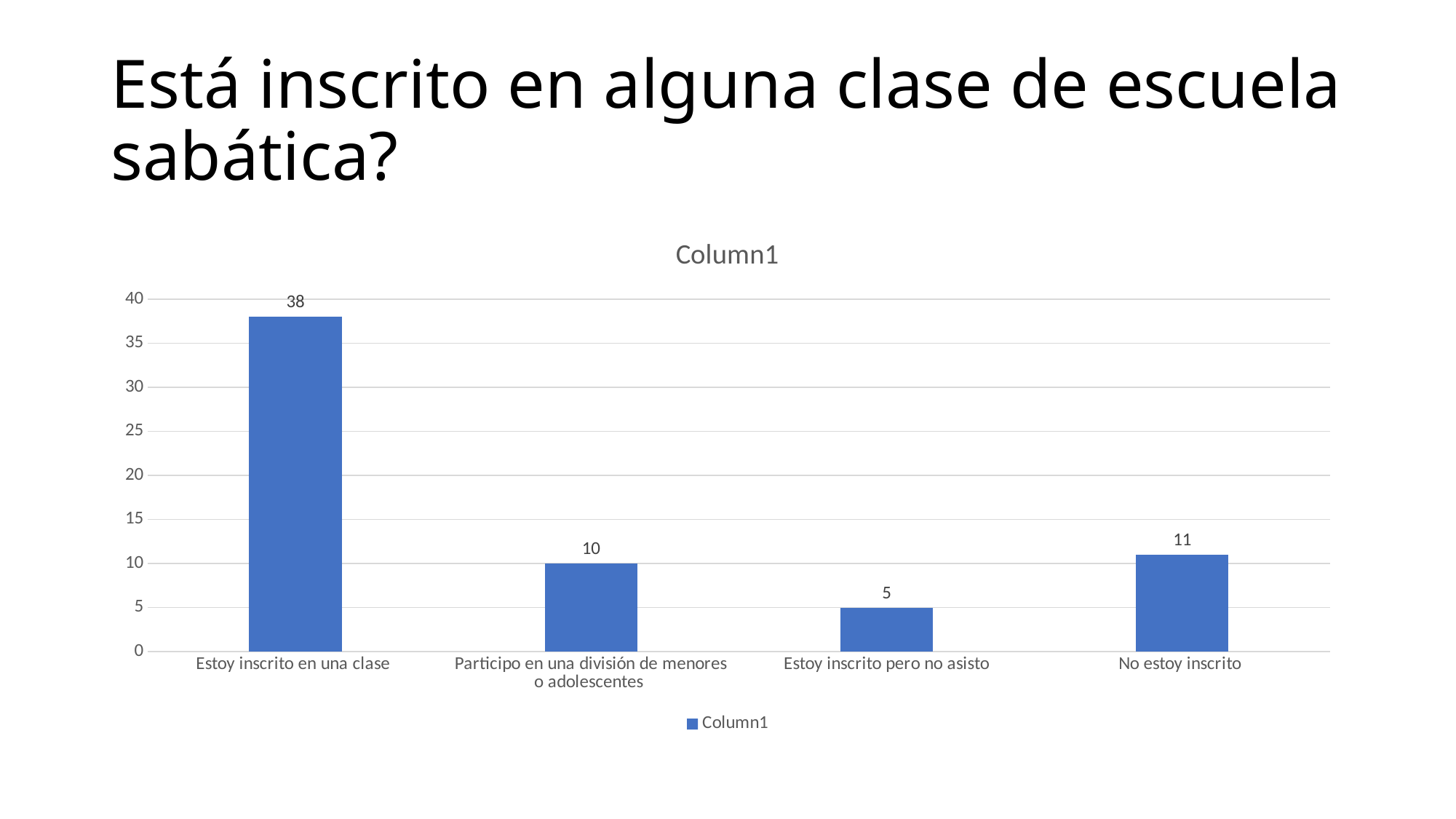
How many categories are shown on the x axis? 4 What is the value for "Estoy inscrito pero no asisto"? 5 Is the value for "Estoy inscrito en una clase" greater or less than 35? greater Which category has the highest value? Estoy inscrito en una clase What is the difference between the values for "Estoy inscrito en una clase" and "No estoy inscrito"? 27 Which category has the lowest value? Estoy inscrito pero no asisto Which is larger, the value for "No estoy inscrito" or the value for "Participo en una división de menores o adolescentes"? No estoy inscrito What is the value for "Participo en una división de menores o adolescentes"? 10 What is the value for "Estoy inscrito en una clase"? 38 What is the value for "No estoy inscrito"? 11 What kind of chart is shown on the slide? bar chart What is the title of the chart? Column1